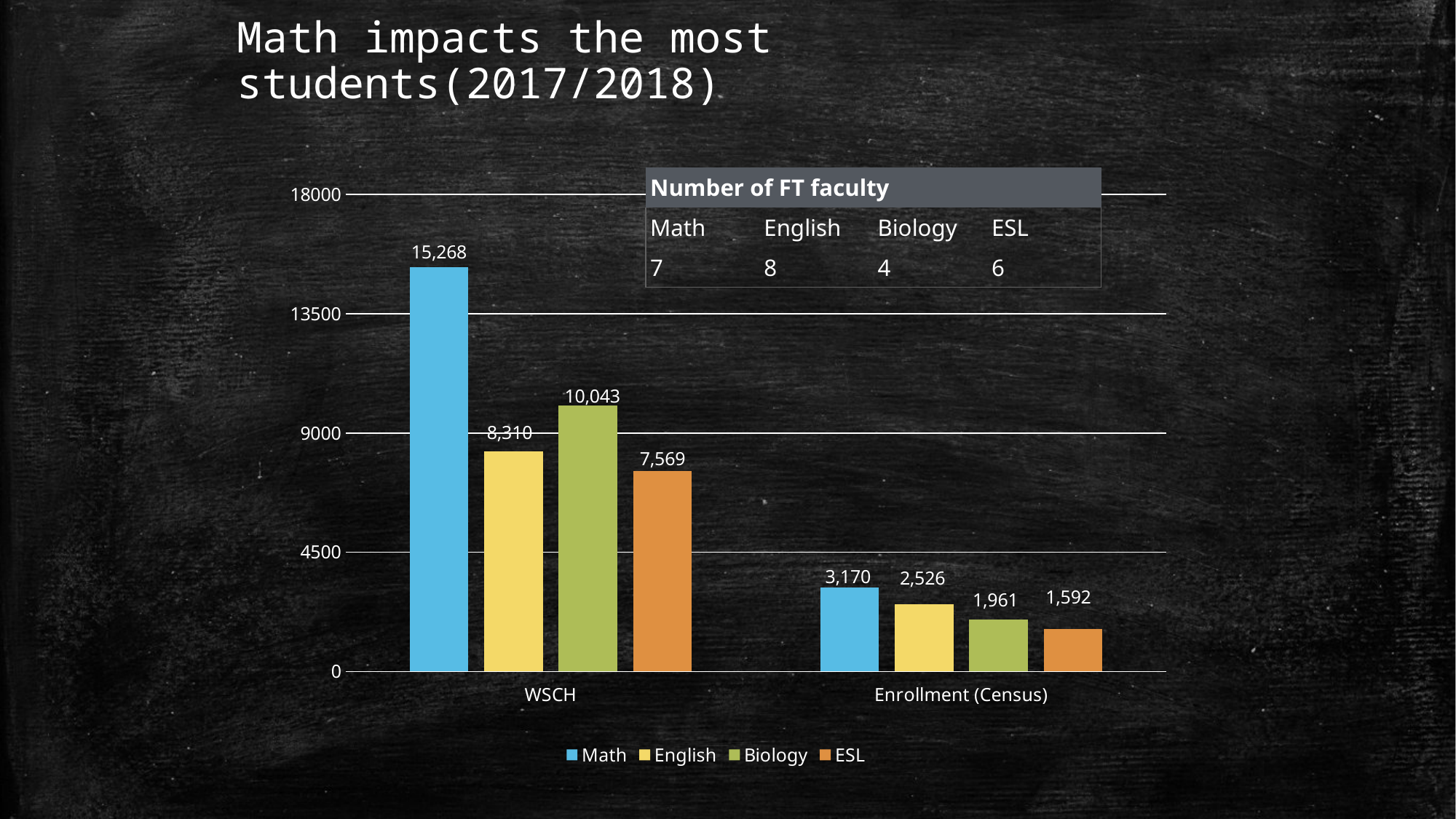
Which is larger, the WSCH value for Biology or for English? Biology Is the WSCH value for Biology greater or less than 9000? greater What kind of chart is shown on the slide? bar chart Which series has the lowest Enrollment (Census) value? ESL How many series does the legend list? 4 How many categories are shown on the x axis? 2 What is the difference between the WSCH values for Math and English? 6,958 What is the Enrollment (Census) value for Biology? 1,961 Which series has the highest WSCH value? Math What is the WSCH value for ESL? 7,569 What is the WSCH value for Math? 15,268 What colour represents the Math series? blue